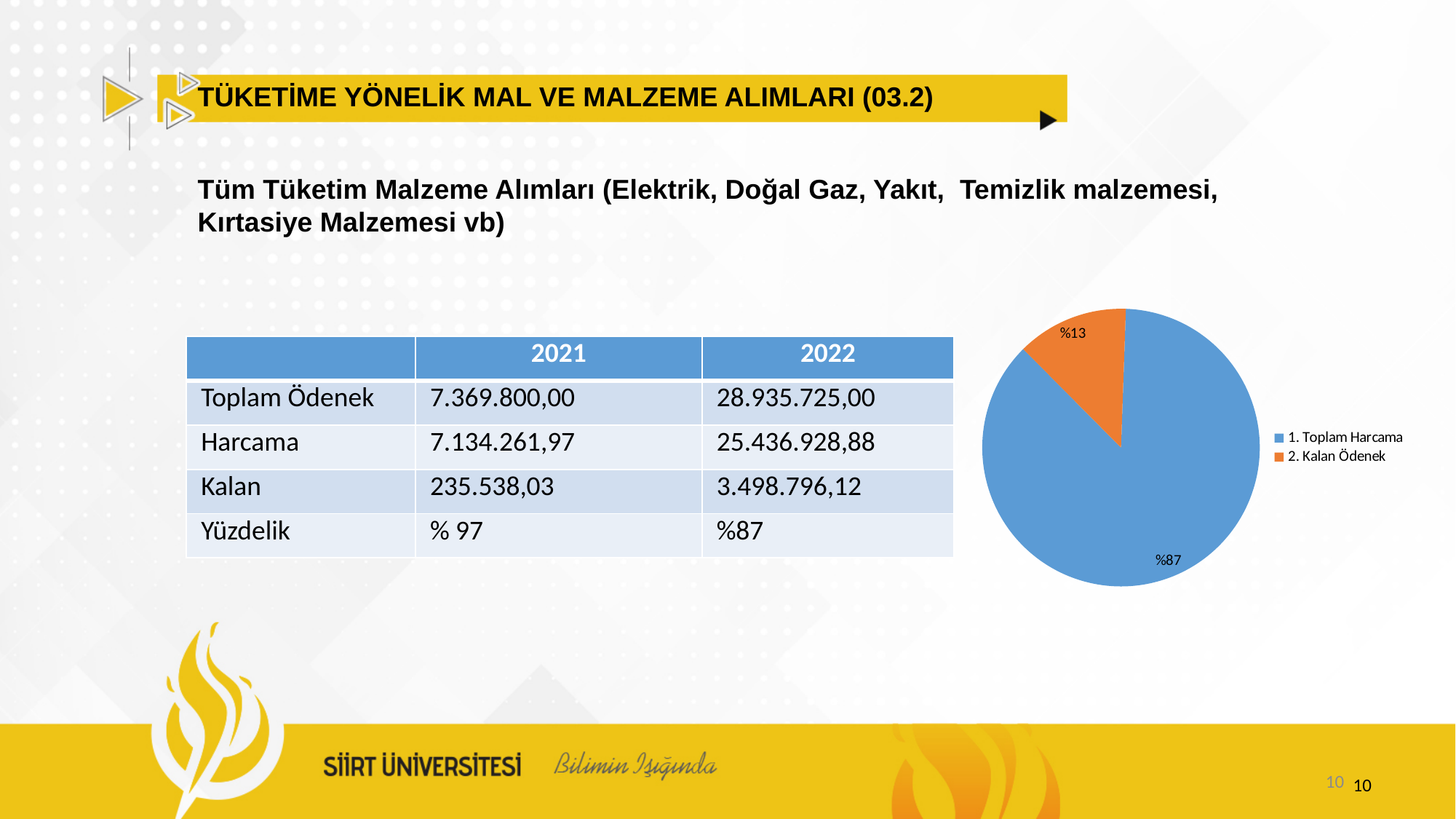
How many entries does the pie chart's legend list? 2 Which slice of the pie chart is the largest? 1. Toplam Harcama By how many percentage points does '1. Toplam Harcama' exceed '2. Kalan Ödenek' in the pie chart? 74 What is the value labelled on the orange slice of the pie chart? %13 Which is larger in the pie chart, '1. Toplam Harcama' or '2. Kalan Ödenek'? 1. Toplam Harcama What share of the pie does '1. Toplam Harcama' represent? %87 Which slice of the pie chart is the smallest? 2. Kalan Ödenek What is the value labelled on the blue slice of the pie chart? %87 What share of the pie does '2. Kalan Ödenek' represent? %13 How many slices does the pie chart have? 2 What kind of chart is shown on the slide? pie chart What colour is the '2. Kalan Ödenek' slice in the pie chart? orange